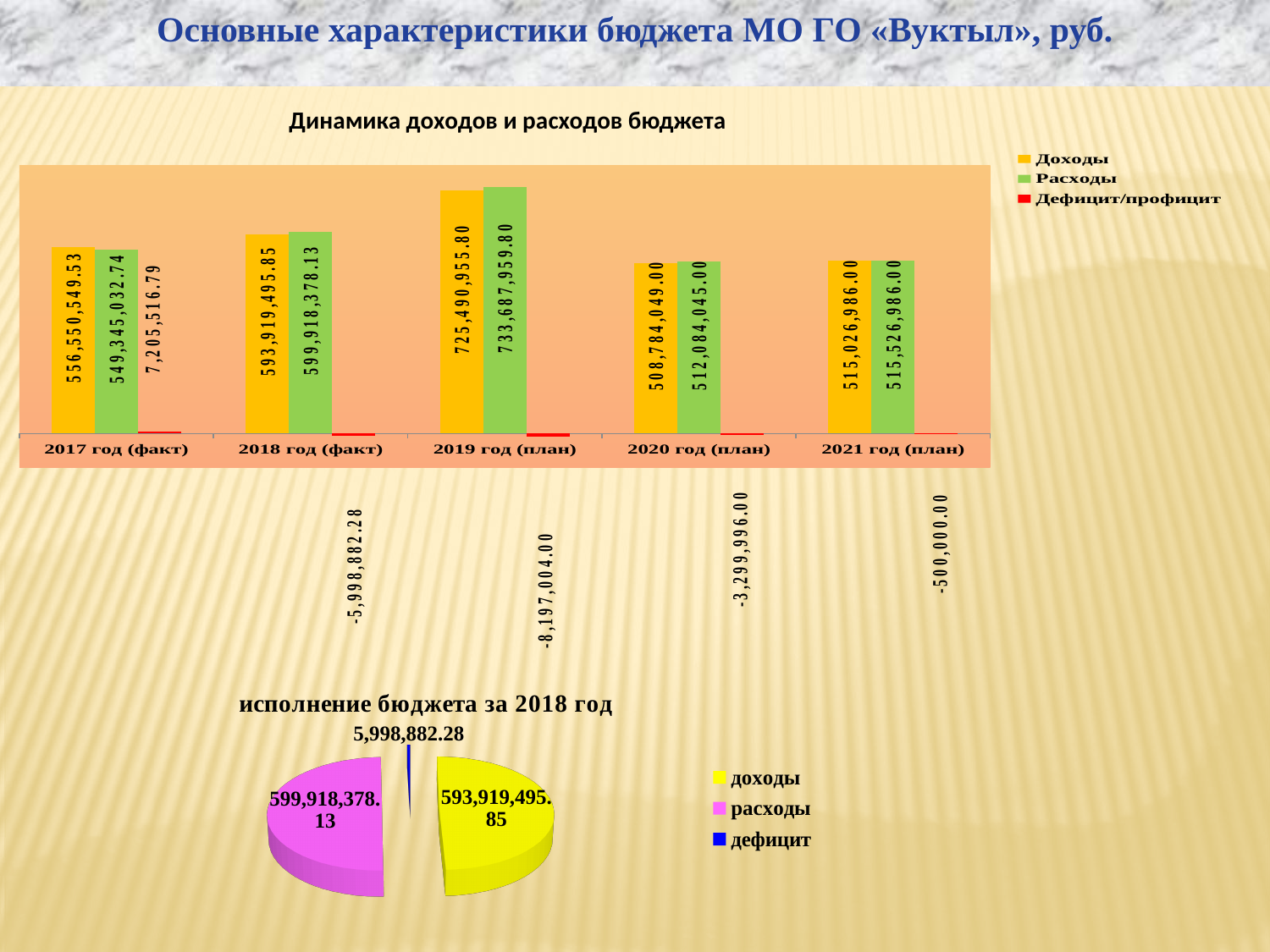
In the pie chart 'исполнение бюджета за 2018 год', what is the value of the расходы slice? 599,918,378.13 In the chart 'Динамика доходов и расходов бюджета', what is the value of Доходы for 2019 год (план)? 725,490,955.80 In the chart 'Динамика доходов и расходов бюджета', what is the difference between Расходы and Доходы for 2021 год (план)? 500,000.00 In the chart 'Динамика доходов и расходов бюджета', what is the Дефицит/профицит value for 2020 год (план)? -3,299,996.00 In the chart 'Динамика доходов и расходов бюджета', which is larger for 2018 год (факт): Доходы or Расходы? Расходы In the pie chart 'исполнение бюджета за 2018 год', what colour is the доходы slice? Yellow What kind of chart is 'Динамика доходов и расходов бюджета'? Bar chart How many series does the legend of the chart 'Динамика доходов и расходов бюджета' list? 3 In the chart 'Динамика доходов и расходов бюджета', which year has the lowest Расходы? 2020 год (план) How many year categories are shown in the chart 'Динамика доходов и расходов бюджета'? 5 In the chart 'Динамика доходов и расходов бюджета', which year has the highest Доходы? 2019 год (план) In the chart 'Динамика доходов и расходов бюджета', what is the value of Расходы for 2017 год (факт)? 549,345,032.74